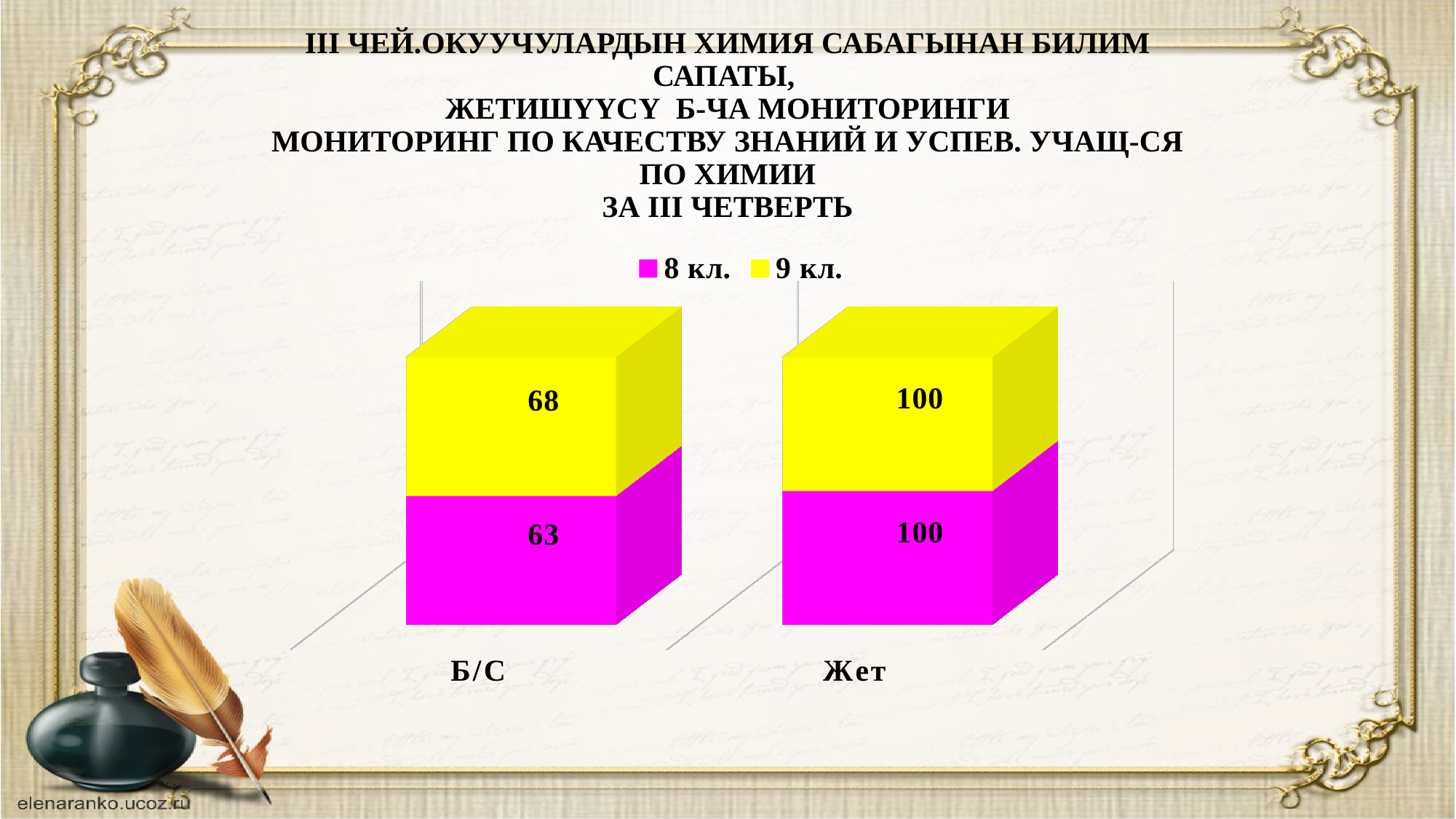
What kind of chart is shown on the slide? Stacked bar chart How many series does the legend list? 2 What is the total of the stacked bar for Жет? 200 In which category is the 8 кл. value highest? Жет What is the value for 9 кл. in the Жет category? 100 What is the total of the stacked bar for Б/С? 131 What is the value for 8 кл. in the Б/С category? 63 How many categories are shown on the x axis? 2 What is the difference between the 9 кл. and 8 кл. values in the Б/С category? 5 What is the value for 9 кл. in the Б/С category? 68 Which is larger in the Б/С category, the 8 кл. value or the 9 кл. value? 9 кл. What is the value for 8 кл. in the Жет category? 100